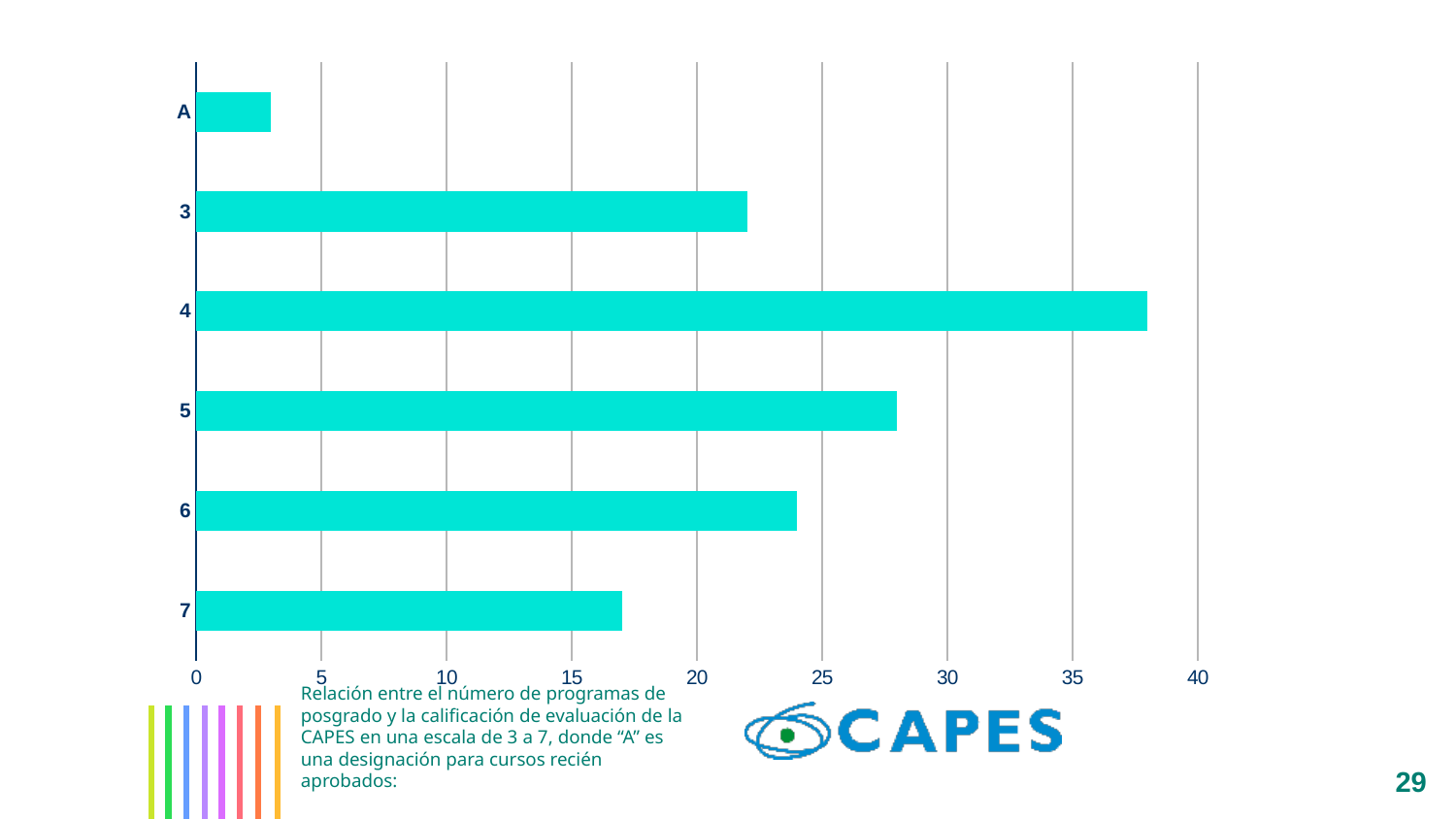
Is the value for category 4 greater or less than 35? greater Which has the larger value, category 3 or category 7? 3 Is the value for category 5 greater or less than 25? greater What kind of chart is shown on the slide? bar chart Is the value for category 6 greater or less than 20? greater Which has the larger value, category 5 or category 6? 5 Which category has the longest bar? 4 How many categories are plotted on the chart? 6 Which category has the shortest bar? A What colour are the bars in the chart? turquoise